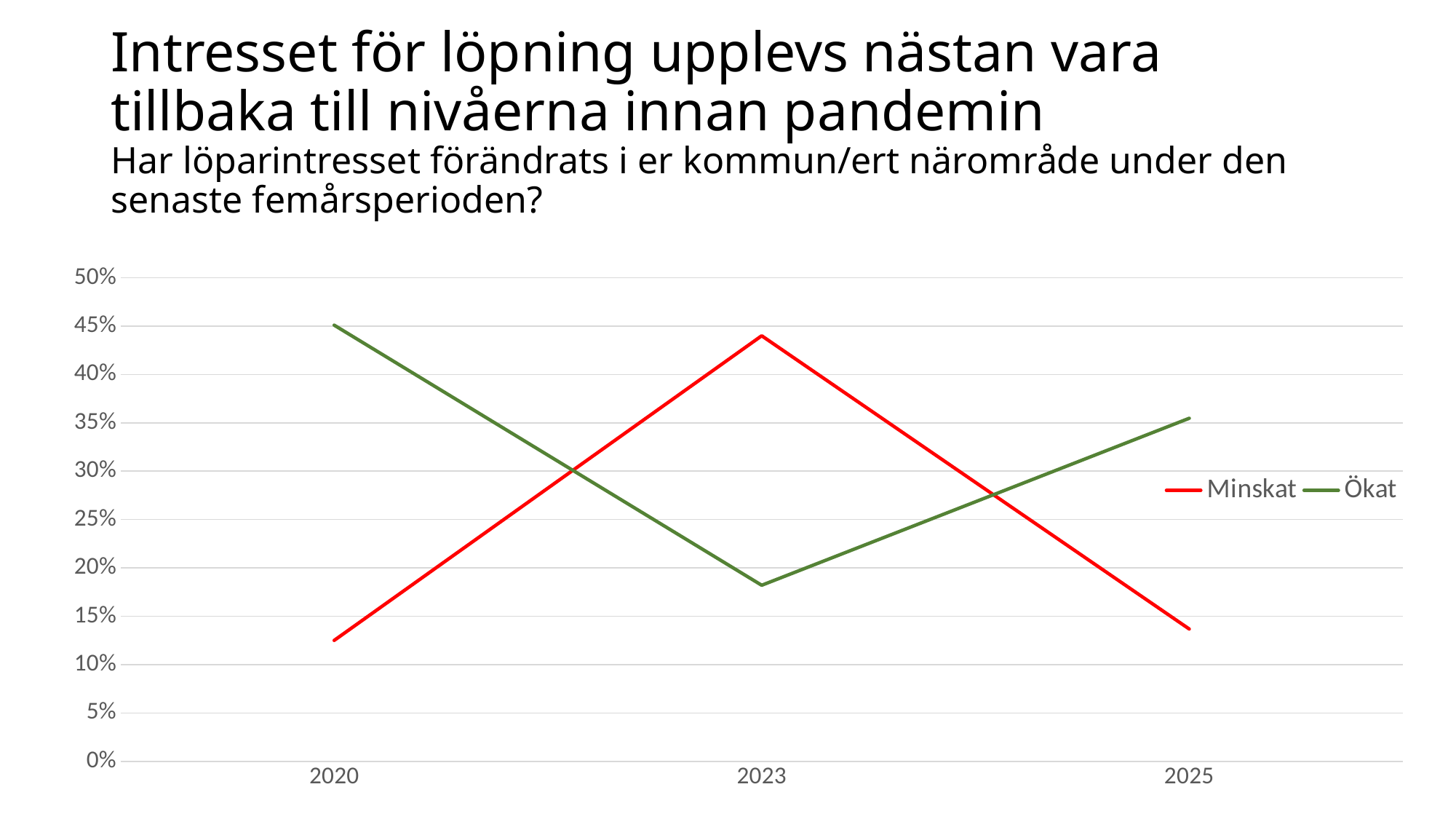
What are the two entries in the legend? Minskat and Ökat In which year does the Ökat series reach its highest value? 2020 In which year does the Minskat series reach its highest value? 2023 In 2020, which series has the larger value, Minskat or Ökat? Ökat Which series is drawn in red? Minskat How many years are plotted along the x axis? 3 How many series does the legend list? 2 What kind of chart is shown on the slide? line chart Does the Ökat series rise or fall from 2020 to 2023? fall In which year does the Ökat series reach its lowest value? 2023 Is the value for Minskat in 2023 greater or less than 40%? greater Is the value for Ökat in 2023 greater or less than 20%? less